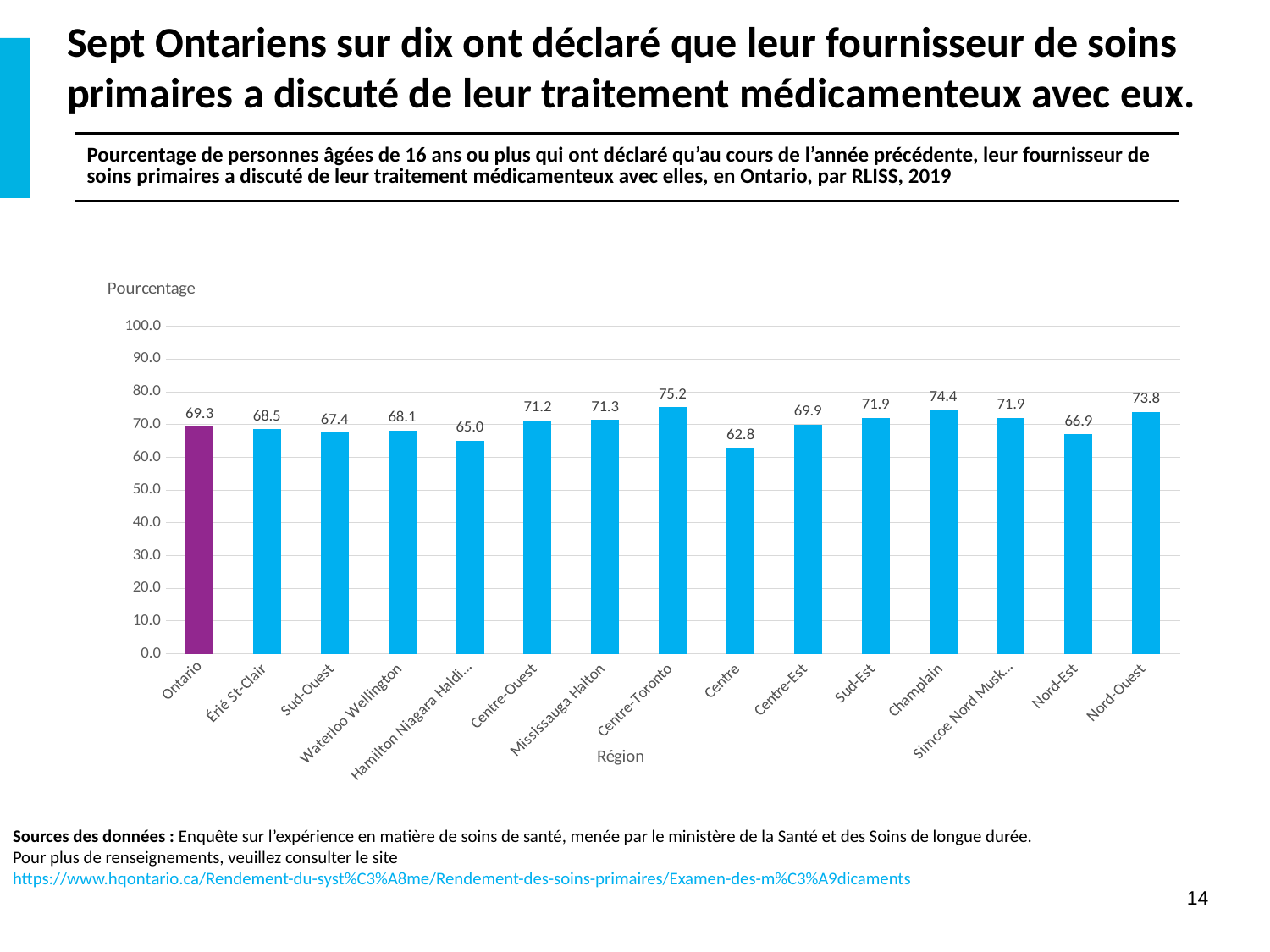
What kind of chart is shown on the slide? bar chart What is the value for Nord-Est? 66.9 What is the value for Ontario? 69.3 What is the label of the x axis? Région How many bars are shown in the chart? 15 Which region has the lowest value? Centre What is the difference between the values for Centre-Toronto and Centre? 12.4 Which is larger, the value for Nord-Ouest or the value for Sud-Ouest? Nord-Ouest Is the value for Centre greater or less than 70.0? less What is the difference between the values for Champlain and Ontario? 5.1 Which region has the highest value? Centre-Toronto What is the value for Centre-Toronto? 75.2